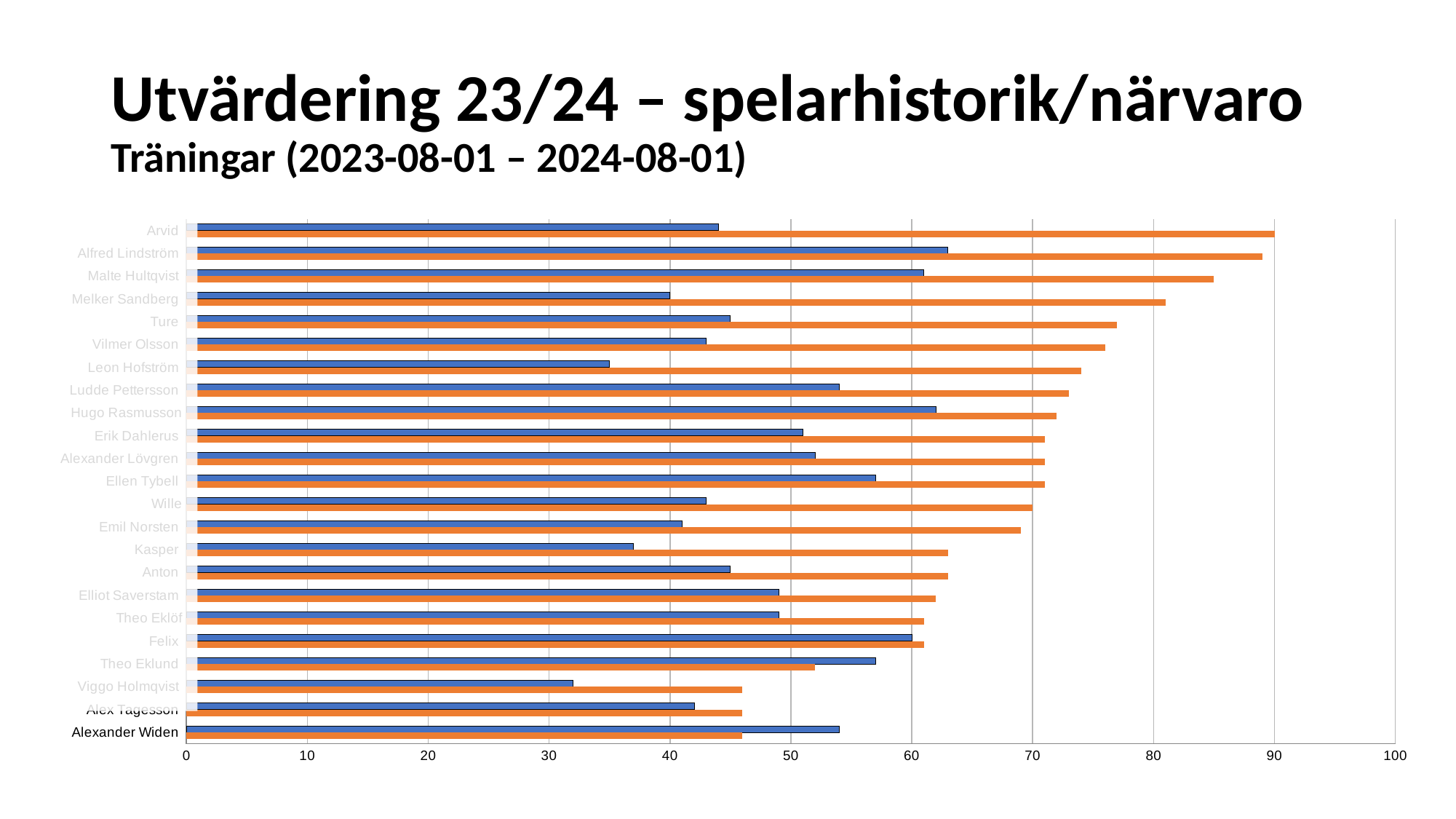
Which is larger: the blue bar for Arvid or the blue bar for Alfred Lindström? Alfred Lindström Going from the top of the chart to the bottom, do the orange bars generally get longer or shorter? shorter Is the value of the orange bar for Kasper greater or less than 60? greater Which player has the shortest blue bar? Viggo Holmqvist How many bars are drawn for each player in the chart? 2 Is the value of the blue bar for Arvid greater or less than 50? less What kind of chart is shown on the slide? bar chart Which player is listed at the top of the chart? Arvid Is the value of the blue bar for Leon Hofström greater or less than 40? less How many players (categories) are listed on the vertical axis of the chart? 23 What is the value of the orange bar for Arvid? 90